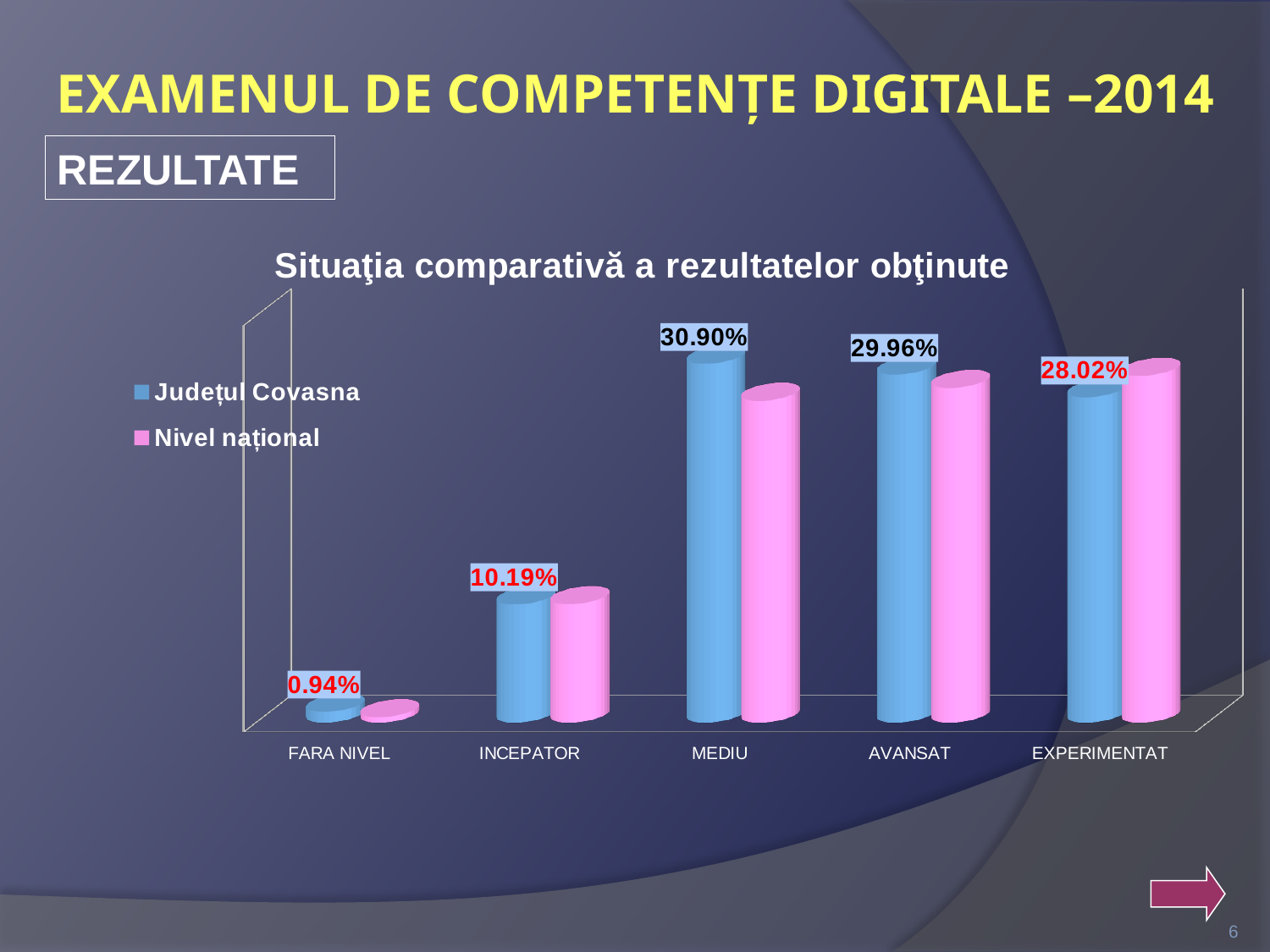
What is the value for Județul Covasna at the FARA NIVEL level? 0.94% How many series does the legend list? 2 What is the difference between the Județul Covasna values for AVANSAT and EXPERIMENTAT? 1.94 percentage points What is the value for Județul Covasna at the MEDIU level? 30.90% What is the value for Județul Covasna at the EXPERIMENTAT level? 28.02% At the MEDIU level, which series has the larger value, Județul Covasna or Nivel național? Județul Covasna What is the value for Județul Covasna at the INCEPATOR level? 10.19% At the EXPERIMENTAT level, which series has the larger value, Județul Covasna or Nivel național? Nivel național Which level has the lowest value for Județul Covasna? FARA NIVEL Which level has the highest value for Județul Covasna? MEDIU How many levels (categories) are shown on the x axis? 5 What is the difference between the Județul Covasna values for MEDIU and AVANSAT? 0.94 percentage points